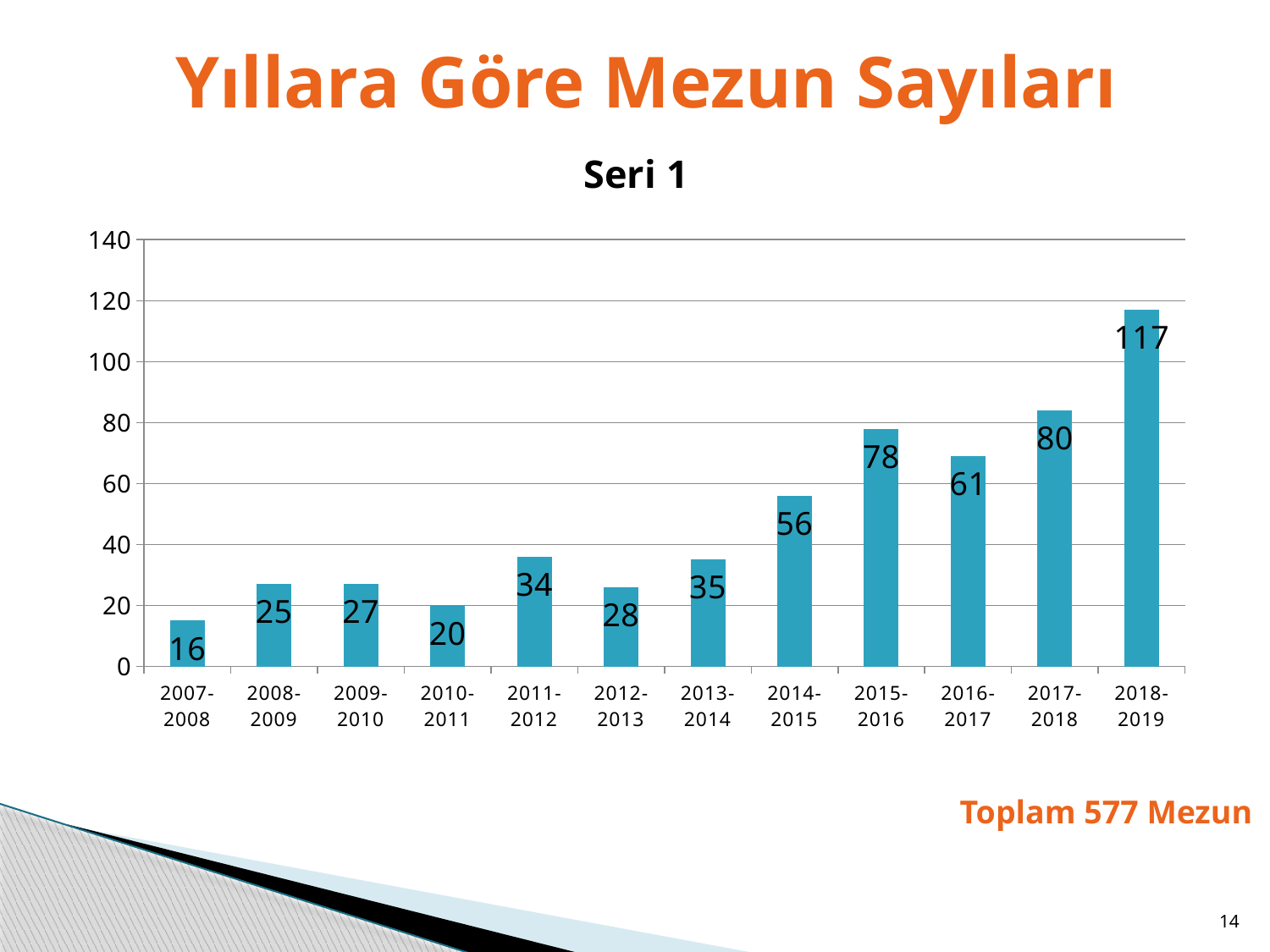
Which year has the highest value? 2018-2019 What is the difference between the values for 2018-2019 and 2017-2018? 37 Is the value for 2017-2018 greater or less than 100? less How many years are shown on the x axis? 12 What is the title of the chart? Seri 1 What is the value for 2010-2011? 20 What kind of chart is shown on the slide? bar chart What is the value for 2018-2019? 117 What is the difference between the values for 2015-2016 and 2016-2017? 17 Which year has the lowest value? 2007-2008 What is the value for 2014-2015? 56